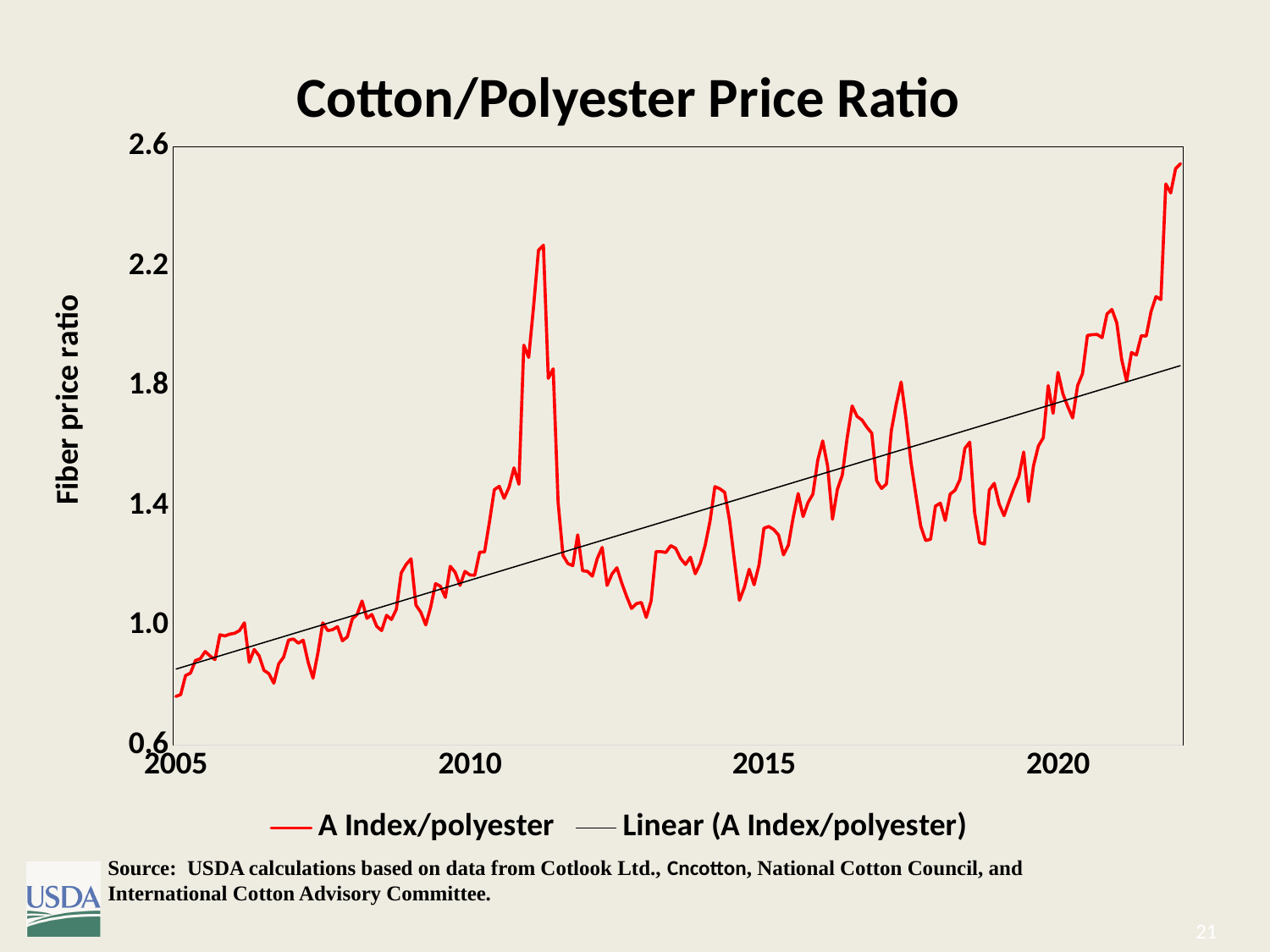
Is the peak value of A Index/polyester around 2011 greater or less than 2.2? greater Does the Linear (A Index/polyester) trend line rise or fall from 2005 to the end of the series? rise Is the value of A Index/polyester at the end of the series greater or less than 2.2? greater What type of chart is shown on the slide? line chart What is the title of the chart? Cotton/Polyester Price Ratio Is the value of A Index/polyester in 2010 greater or less than 1.0? greater How many series does the legend list? 2 Which is higher: the A Index/polyester peak around 2011 or the value at the end of the series? the value at the end of the series What is the label on the vertical axis? Fiber price ratio